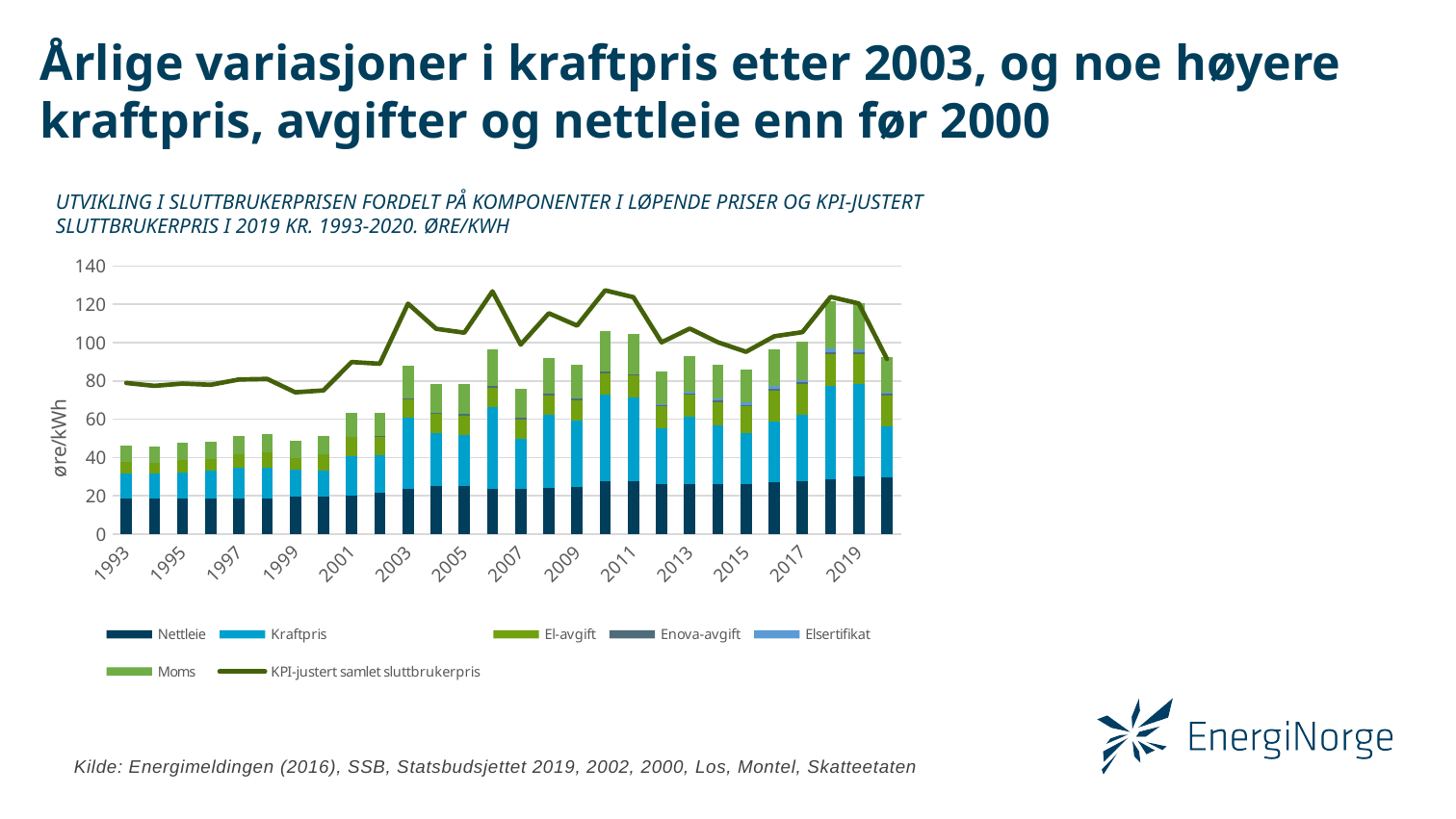
Which year has the larger total stacked bar, 1993 or 2003? 2003 How many years (bars) are plotted on the x axis? 28 What is the label on the y axis? øre/kWh Does the KPI-justert samlet sluttbrukerpris line rise or fall from 2018 to 2020? fall Is the total stacked bar for 2003 greater or less than 80? greater How many series does the legend list? 7 Is the total stacked bar for 1993 greater or less than 60? less Is the total stacked bar for 2010 greater or less than 100? greater Which legend entry is drawn as a line rather than a bar segment? KPI-justert samlet sluttbrukerpris Which year has the larger total stacked bar, 2010 or 2020? 2010 What kind of chart is shown on the slide? Stacked bar chart with a line